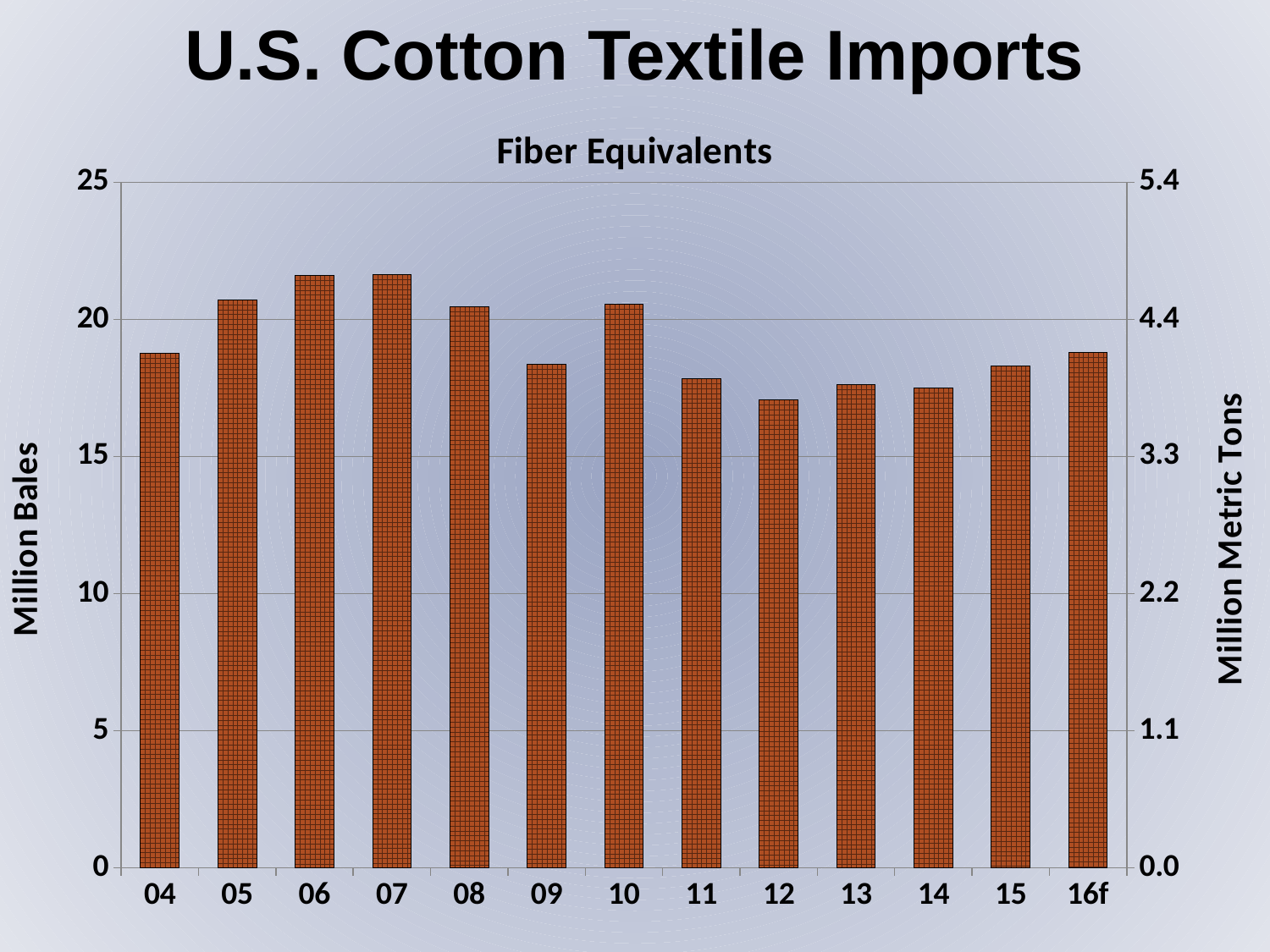
Is the value for 11 greater or less than 20 million bales? less Is the value for 06 greater or less than 20 million bales? greater Which is larger, the value for 08 or the value for 14? 08 Which is larger, the value for 05 or the value for 12? 05 Is the value for 04 greater or less than 15 million bales? greater Do the values rise or fall from 07 to 09? fall What is the label of the right vertical axis? Million Metric Tons What kind of chart is shown on the slide? bar chart Which year has the lowest value for U.S. cotton textile imports? 12 What is the label of the left vertical axis? Million Bales How many years (categories) are shown on the x axis? 13